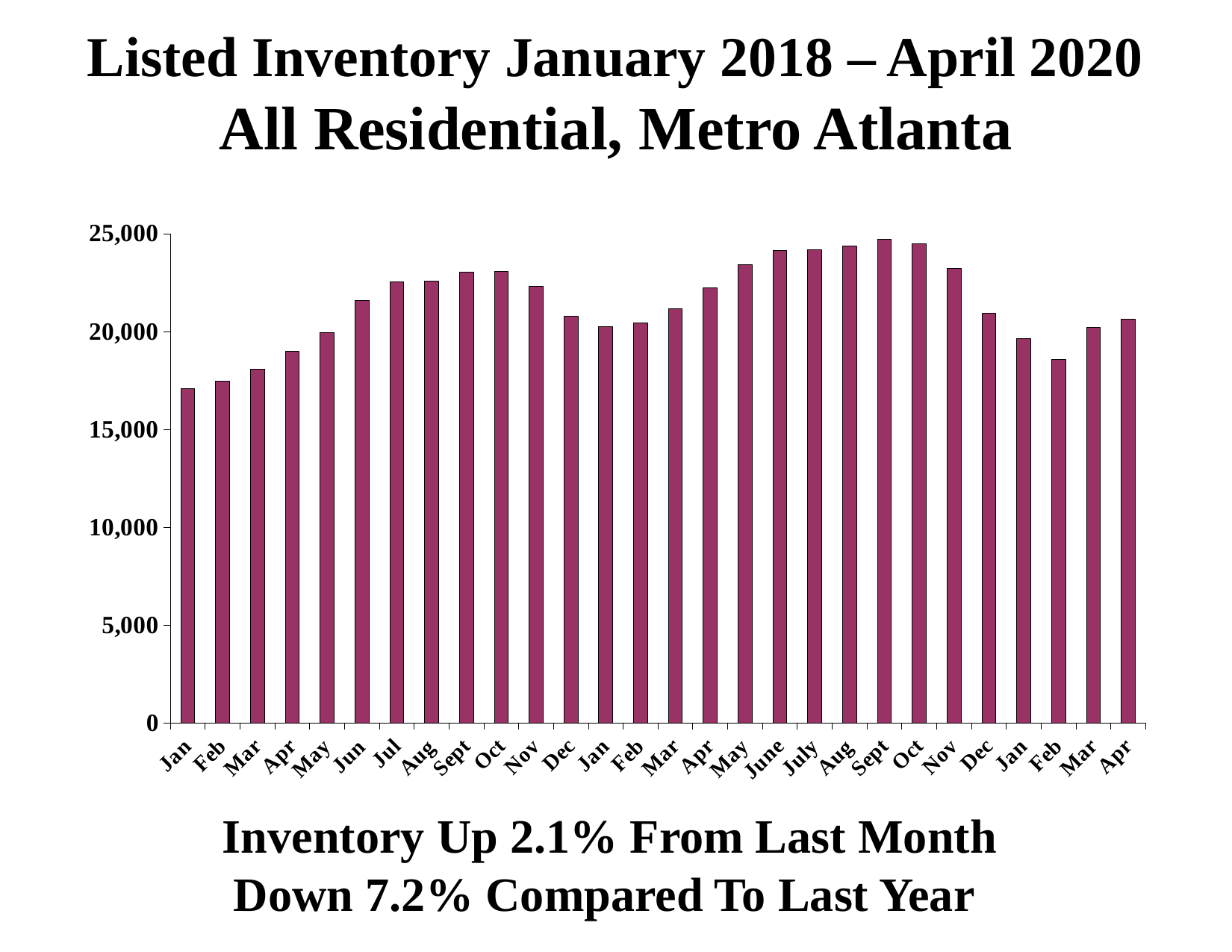
How many monthly bars are plotted in the chart? 28 Is the value for Jun 2018 greater or less than 20,000? greater What kind of chart is shown on the slide? bar chart Which is larger, the value for Feb 2020 or the value for Sept 2019? Sept 2019 Is the value for the first Jan bar (January 2018) greater or less than 20,000? less Which is larger, the value for Nov 2018 or the value for Nov 2019? Nov 2019 According to the text below the chart, by what percentage is inventory down compared to last year? 7.2% Which month has the lowest listed inventory in the chart? Jan 2018 (the first bar) Is the value for Feb 2020 greater or less than 20,000? less Do the values rise or fall from Jan 2018 to Oct 2018? rise Which month has the highest listed inventory in the chart? Sept 2019